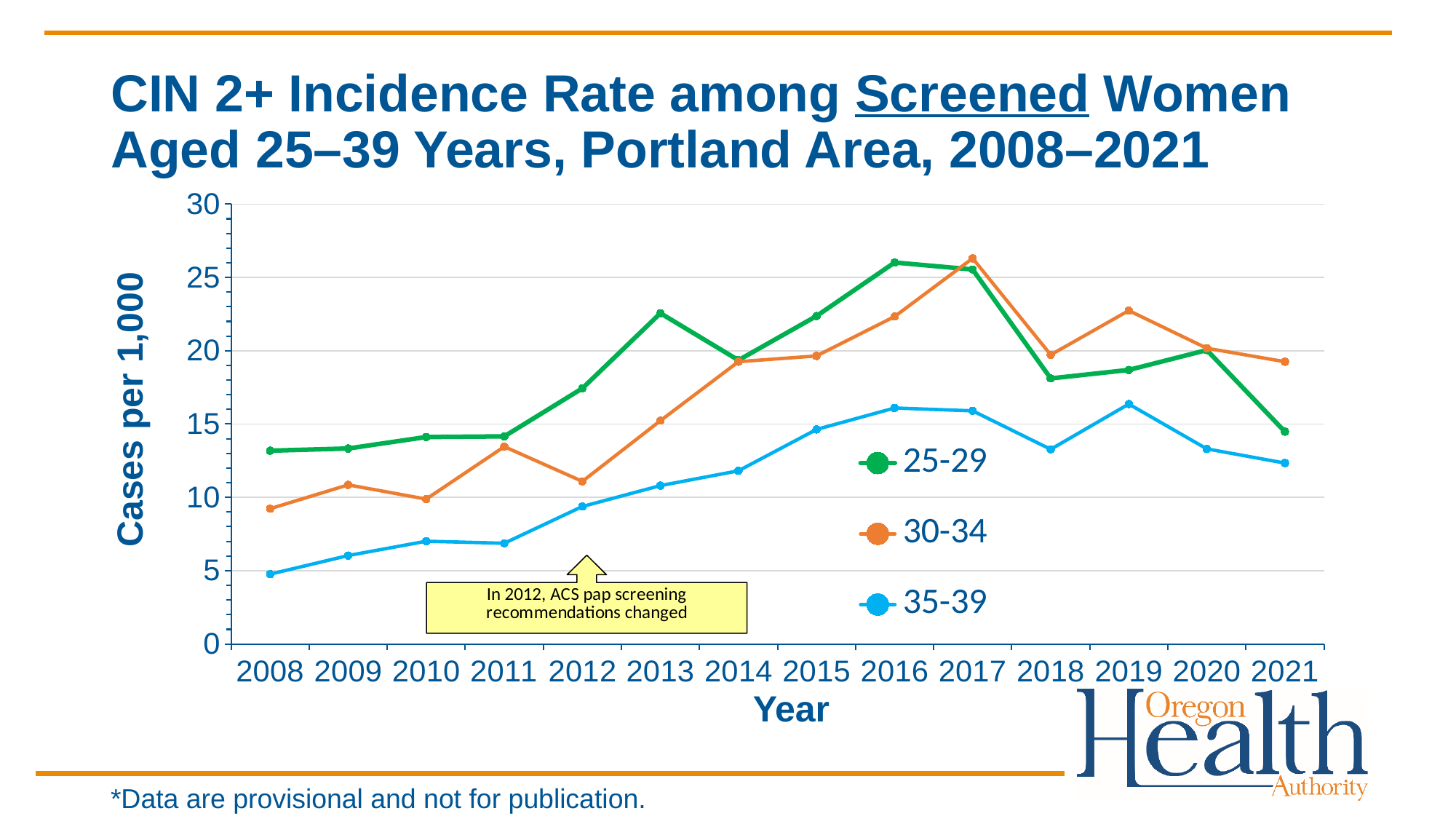
In which year does the 30-34 series reach its highest value? 2017 Is the value for the 25-29 series in 2013 greater or less than 20? greater What kind of chart is shown on the slide? line chart How many years are plotted along the x axis? 14 Is the value for the 25-29 series in 2016 greater or less than 25? greater In 2021, which series has the higher value, 25-29 or 30-34? 30-34 Is the value for the 35-39 series in 2021 greater or less than 15? less Does the 35-39 series rise or fall from 2008 to 2016? rise How many series does the legend list? 3 What is the label on the y axis? Cases per 1,000 In which year is the 35-39 series at its lowest value? 2008